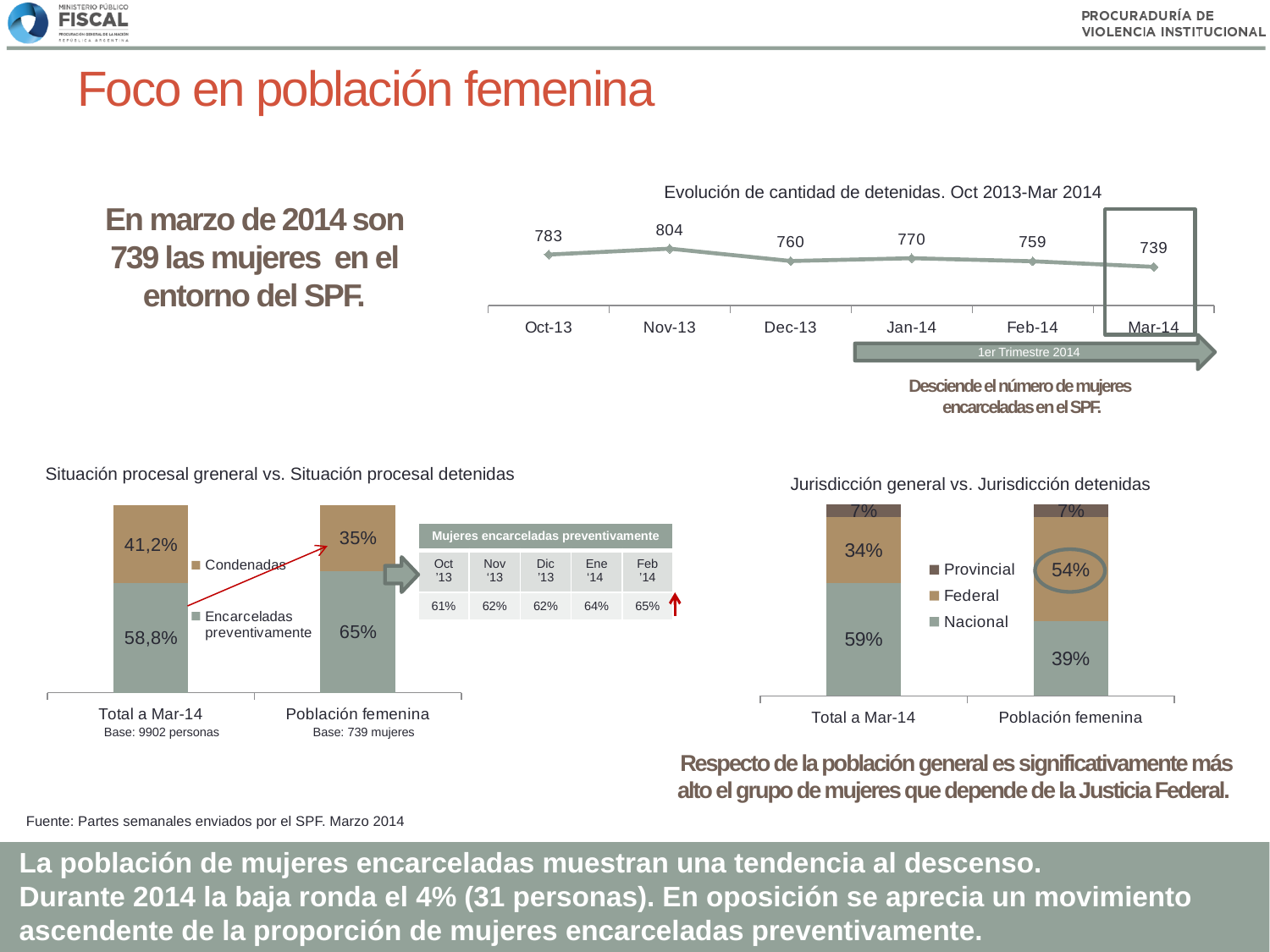
In the chart 'Evolución de cantidad de detenidas. Oct 2013-Mar 2014', what is the difference between the Oct-13 and Mar-14 values? 44 In the chart 'Jurisdicción general vs. Jurisdicción detenidas', what is the value for Federal in the Población femenina bar? 54% In the chart 'Situación procesal greneral vs. Situación procesal detenidas', what is the value for Condenadas in the Población femenina bar? 35% In the chart 'Situación procesal greneral vs. Situación procesal detenidas', how many series does the legend list? 2 In the chart 'Jurisdicción general vs. Jurisdicción detenidas', how many series does the legend list? 3 What kind of chart is 'Evolución de cantidad de detenidas. Oct 2013-Mar 2014'? Line chart In the chart 'Evolución de cantidad de detenidas. Oct 2013-Mar 2014', which month has the lowest value? Mar-14 In the chart 'Evolución de cantidad de detenidas. Oct 2013-Mar 2014', what is the value for Nov-13? 804 In the chart 'Situación procesal greneral vs. Situación procesal detenidas', what is the value for Encarceladas preventivamente in the Total a Mar-14 bar? 58,8% In the chart 'Jurisdicción general vs. Jurisdicción detenidas', which is larger: Nacional for Total a Mar-14 or Nacional for Población femenina? Total a Mar-14 In the chart 'Evolución de cantidad de detenidas. Oct 2013-Mar 2014', which month has the highest value? Nov-13 In the chart 'Evolución de cantidad de detenidas. Oct 2013-Mar 2014', how many months are plotted? 6